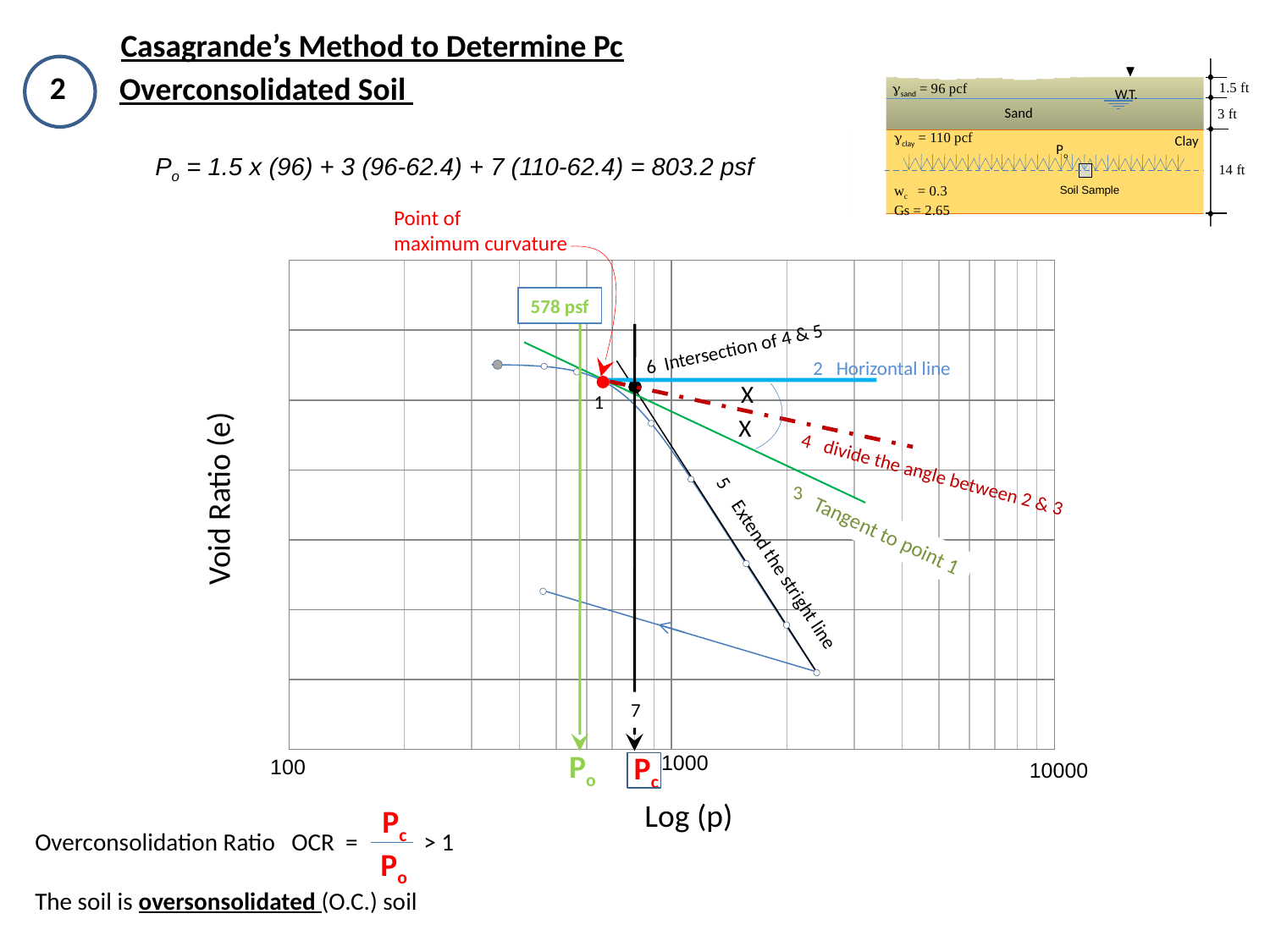
Is the value of Po on the chart greater or less than 100? greater Along the loading curve, does the void ratio rise or fall as p increases? fall What is the smallest tick value printed on the x-axis of the chart? 100 Is the value of Po on the chart greater or less than 1000? less What kind of chart is shown on the slide? line chart Which is larger on the chart, Pc or Po? Pc What is the label of the y-axis of the chart? Void Ratio (e) What is the largest tick value printed on the x-axis of the chart? 10000 What is the label of the x-axis of the chart? Log (p) Is the value of Pc on the chart greater or less than 1000? less How many tick labels are printed on the x-axis of the chart? 3 What value is printed in the box above the green vertical line on the chart? 578 psf